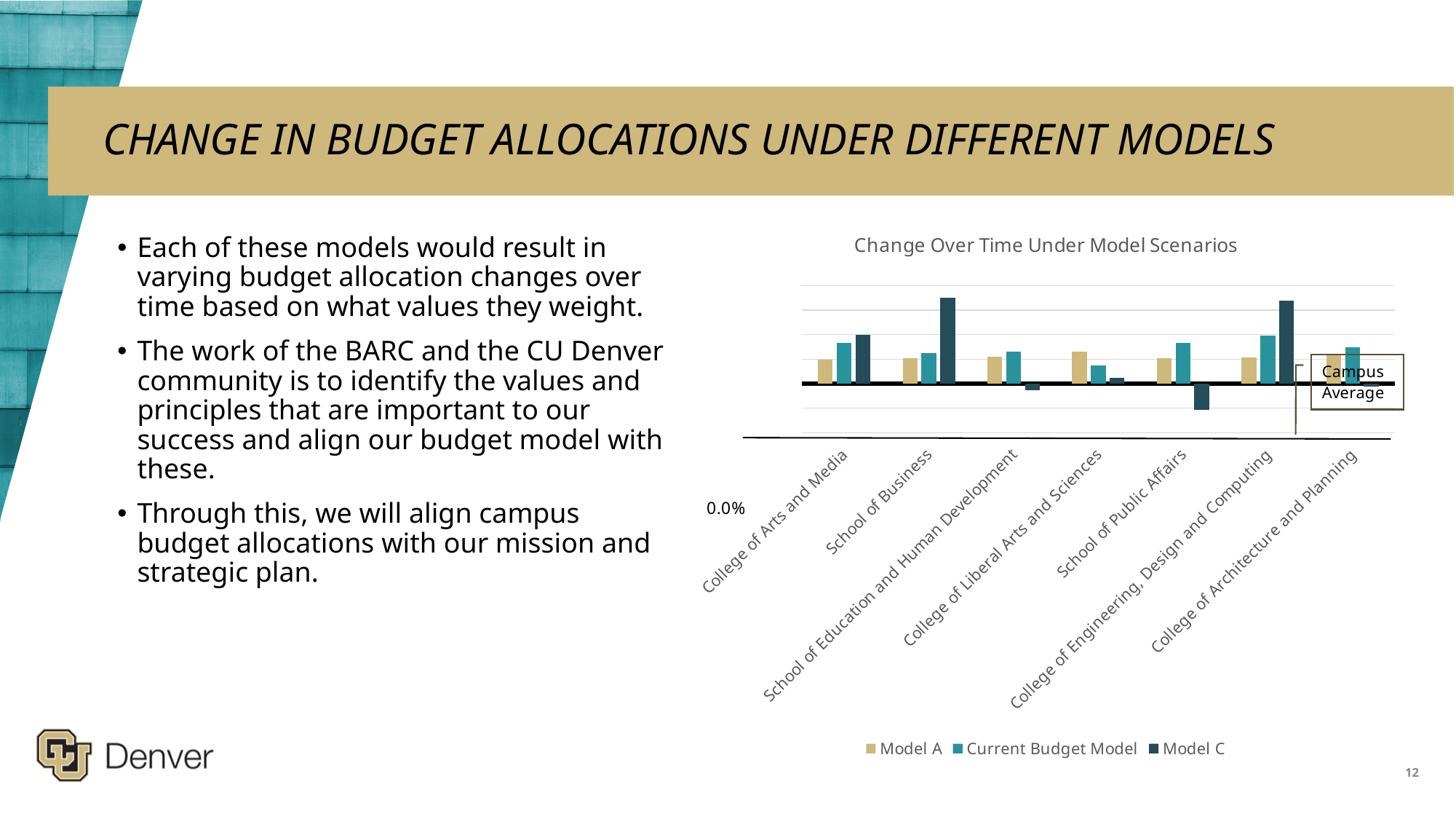
Is the Model C value for School of Business greater or less than 0.0%? greater For College of Liberal Arts and Sciences, which is larger: the Model A value or the Current Budget Model value? Model A Which college or school has the lowest Model C value? School of Public Affairs What is the title of the chart? Change Over Time Under Model Scenarios Is the Model C value for School of Education and Human Development greater or less than 0.0%? less How many colleges or schools are shown on the x axis of the chart? 7 For School of Public Affairs, which is larger: the Current Budget Model value or the Model C value? Current Budget Model For School of Business, which is larger: the Model A value or the Model C value? Model C Is the Model C value for School of Public Affairs greater or less than 0.0%? less What type of chart is shown on the slide? Bar chart Which series are listed in the chart legend? Model A, Current Budget Model, Model C How many series does the chart legend list? 3